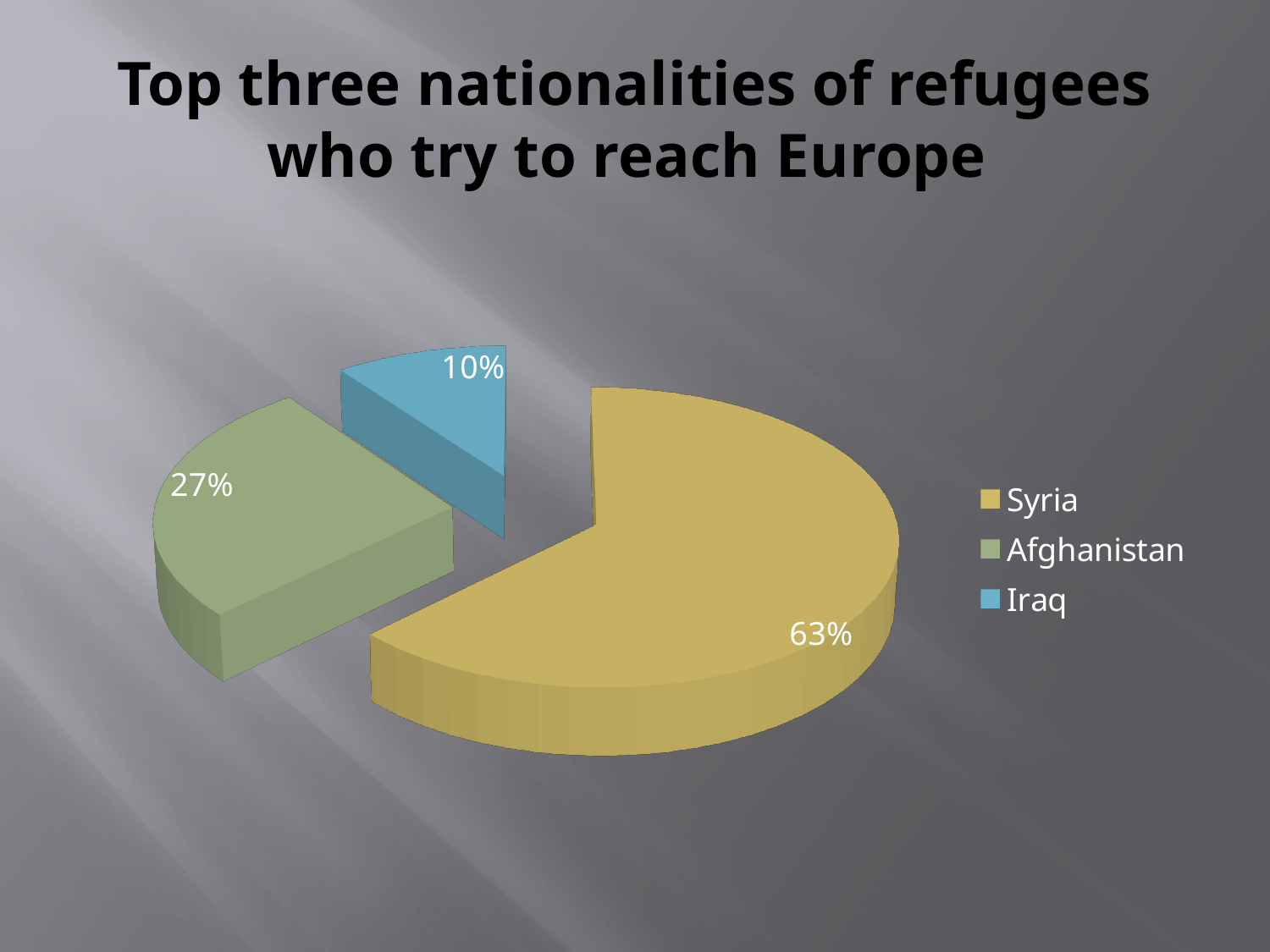
What percentage of the pie does Afghanistan account for? 27% What is the title of the chart? Top three nationalities of refugees who try to reach Europe What percentage of the pie does Syria account for? 63% What percentage of the pie does Iraq account for? 10% How many nationalities are shown in the pie chart? 3 Which colour represents Iraq in the pie chart? Blue What is the difference in percentage points between Afghanistan's share and Iraq's share? 17 Which nationality has the largest share of the pie? Syria Which has a larger share, Afghanistan or Iraq? Afghanistan What kind of chart is shown on the slide? Pie chart What is the difference in percentage points between Syria's share and Afghanistan's share? 36 Which nationality has the smallest share of the pie? Iraq